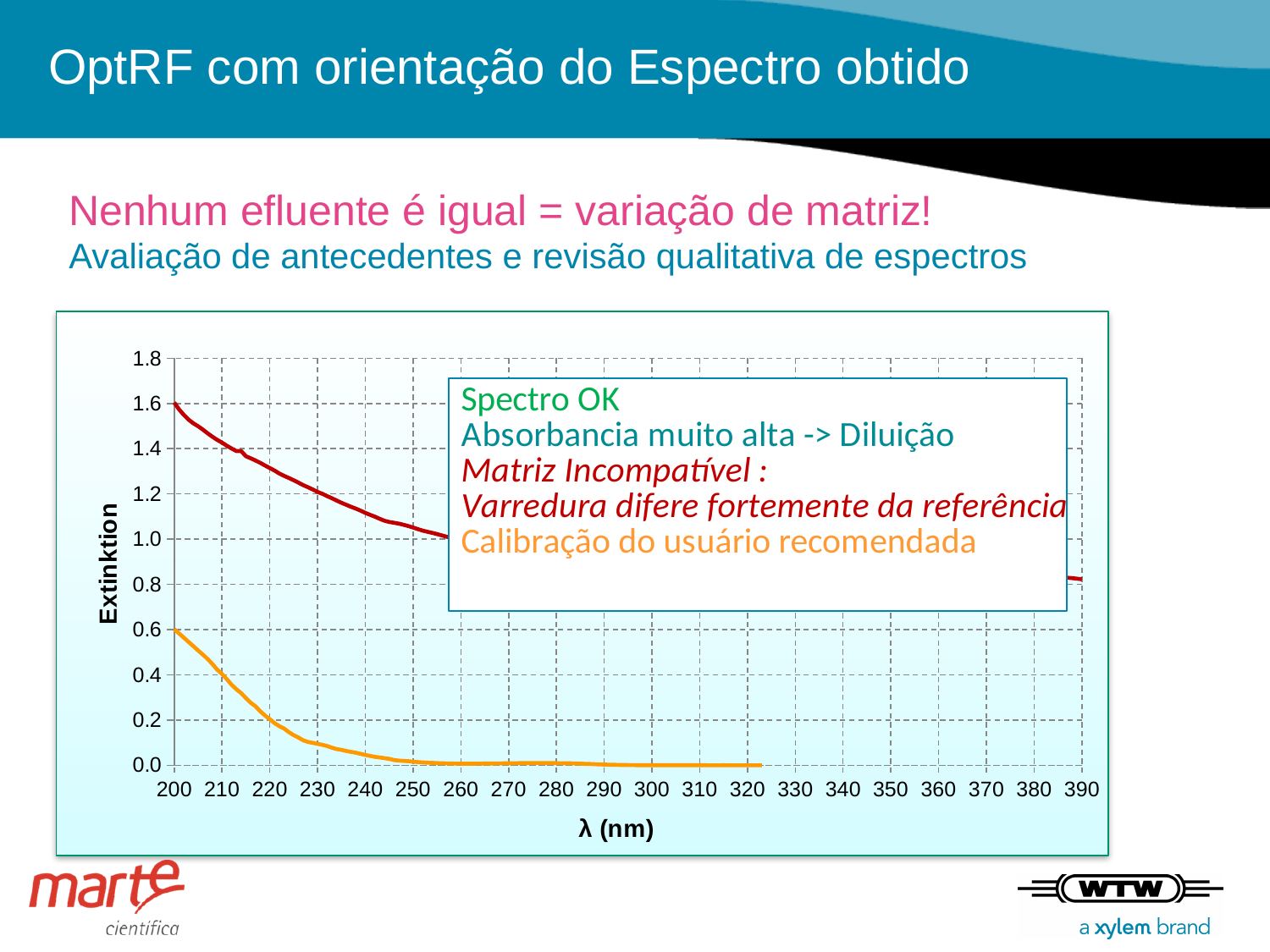
Does the red line rise or fall as the wavelength increases along the x axis? fall Is the value of the red line at 390 nm greater or less than 0.6? greater What is the highest value shown on the y axis of the chart? 1.8 Is the value of the red line at 200 nm greater or less than 1.4? greater Does the orange line rise or fall as the wavelength increases from 200 nm to 250 nm? fall How many lines are plotted on the chart? 2 At 200 nm, which line has the higher value, the red line or the orange line? the red line What is the label of the x axis of the chart? λ (nm) Is the value of the orange line at 200 nm greater or less than 0.8? less What kind of chart is shown on the slide? line chart What is the label of the y axis of the chart? Extinktion